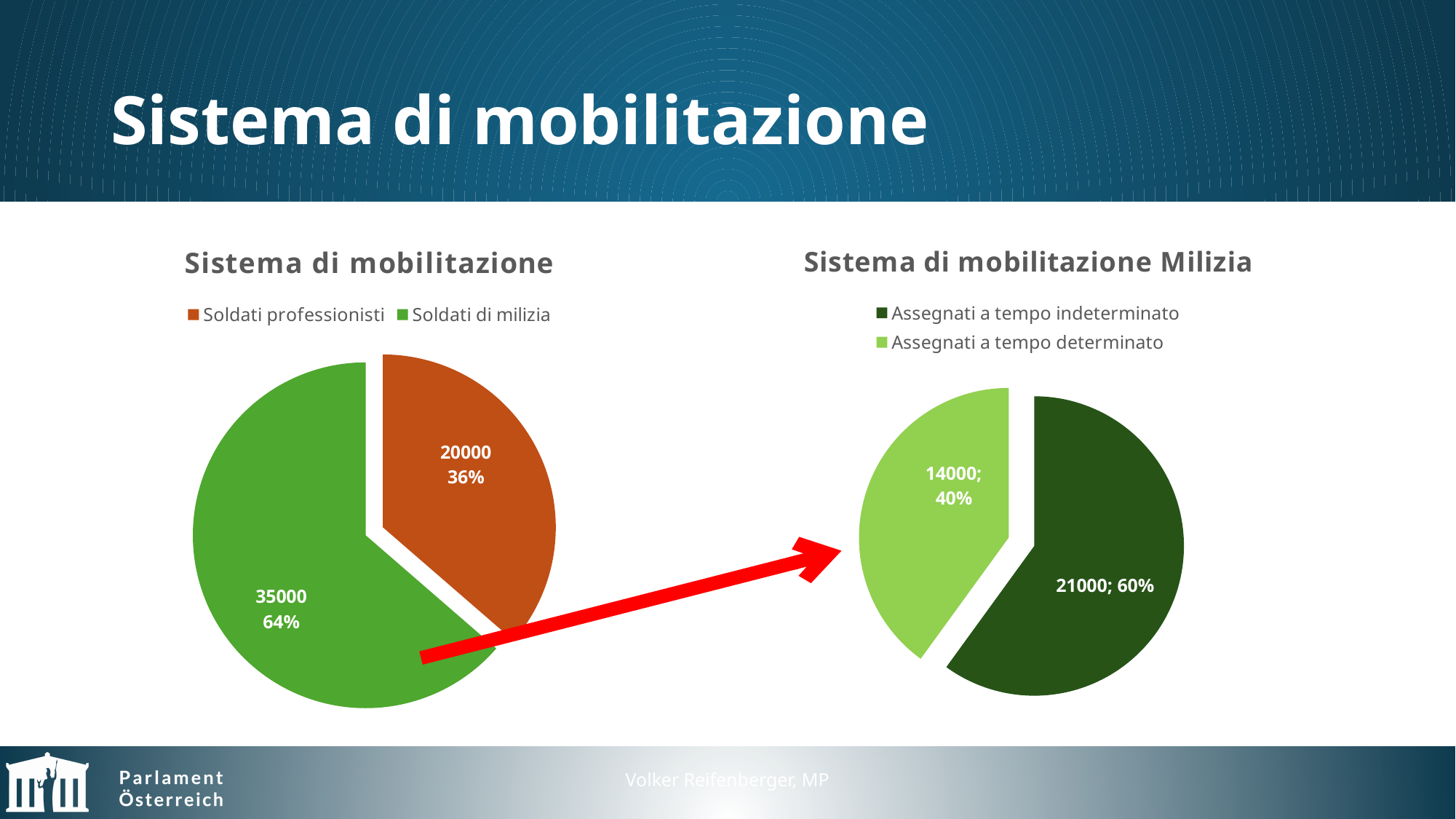
In the 'Sistema di mobilitazione Milizia' chart, what is the value for Assegnati a tempo determinato? 14000 In the 'Sistema di mobilitazione Milizia' chart, what is the value for Assegnati a tempo indeterminato? 21000 What kind of chart is the 'Sistema di mobilitazione' chart? Pie chart In the 'Sistema di mobilitazione Milizia' chart, what is the total of the two slices? 35000 In the 'Sistema di mobilitazione' chart, what is the value for Soldati professionisti? 20000 In the 'Sistema di mobilitazione' chart, which category is the largest? Soldati di milizia In the 'Sistema di mobilitazione' chart, what is the difference between Soldati di milizia and Soldati professionisti? 15000 In the 'Sistema di mobilitazione Milizia' chart, what share of the pie is Assegnati a tempo determinato? 40% In the 'Sistema di mobilitazione Milizia' chart, how many categories does the legend list? 2 In the 'Sistema di mobilitazione Milizia' chart, which category is the smallest? Assegnati a tempo determinato In the 'Sistema di mobilitazione' chart, what is the value for Soldati di milizia? 35000 In the 'Sistema di mobilitazione' chart, what share of the pie is Soldati di milizia? 64%